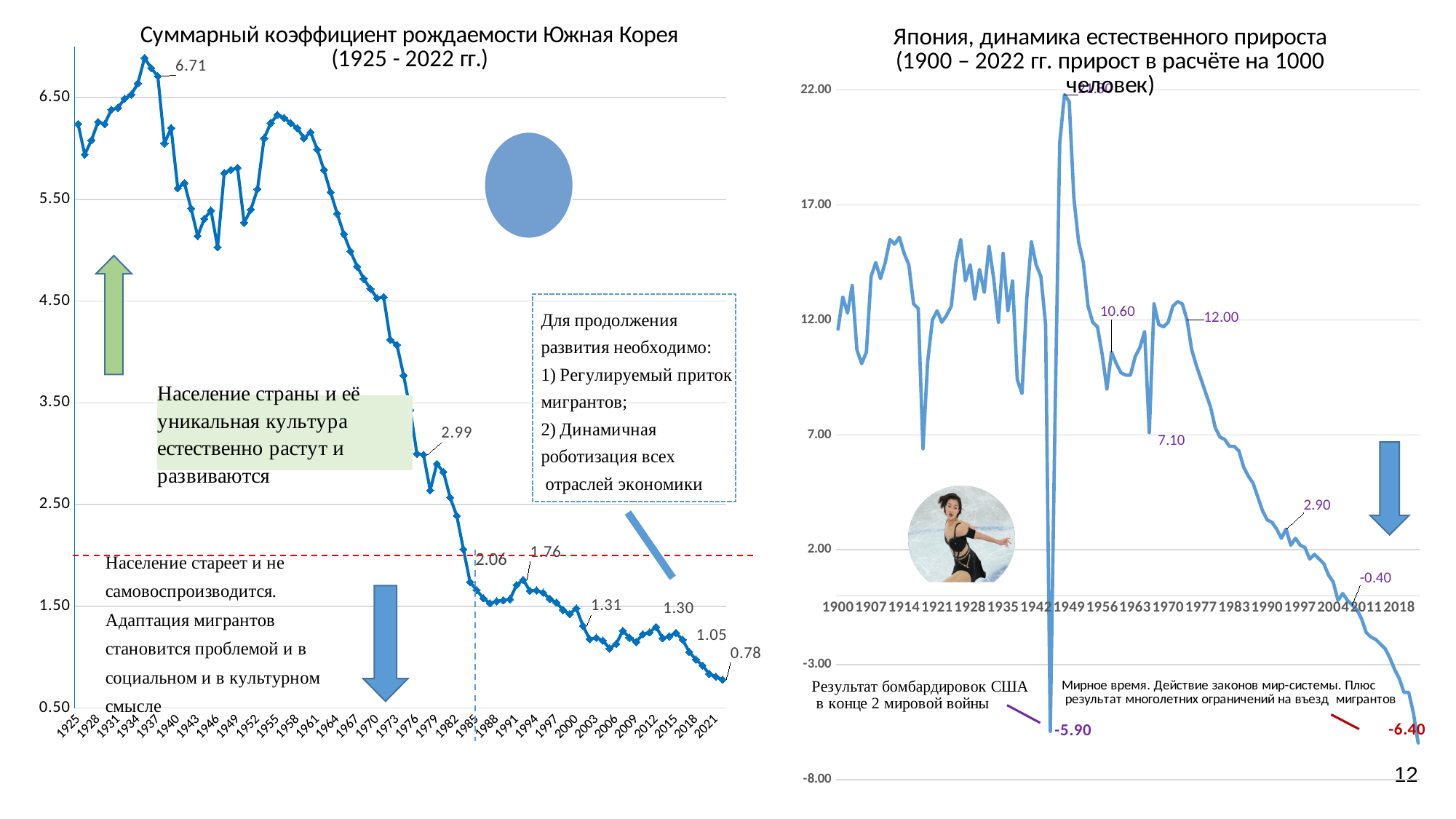
On the left chart (South Korea fertility rate), what is the highest labeled value? 6.71 On the right chart (Japan natural increase), which labeled value is larger: 10.60 or 2.90? 10.60 On the left chart (South Korea fertility rate), what is the last labeled value at the right end of the line? 0.78 On the left chart (South Korea fertility rate), is the value for 1925 greater or less than 5.50? greater On the right chart (Япония, динамика естественного прироста), what is the lowest labeled value? -6.40 On the left chart (South Korea fertility rate), do the values overall rise or fall from 1925 to 2022? fall On the right chart (Japan natural increase), is the value for 1990 greater or less than 7.00? less On the left chart (South Korea fertility rate), what is the difference between the labeled values 6.71 and 0.78? 5.93 On the left chart (South Korea fertility rate), is the value for 2012 greater or less than 1.50? less On the left chart (South Korea fertility rate), what is the difference between the labeled values 2.06 and 1.76? 0.30 On the right chart (Japan natural increase), what is the difference between the labeled values 12.00 and 7.10? 4.90 What kind of chart is the left chart (Суммарный коэффициент рождаемости Южная Корея)? line chart